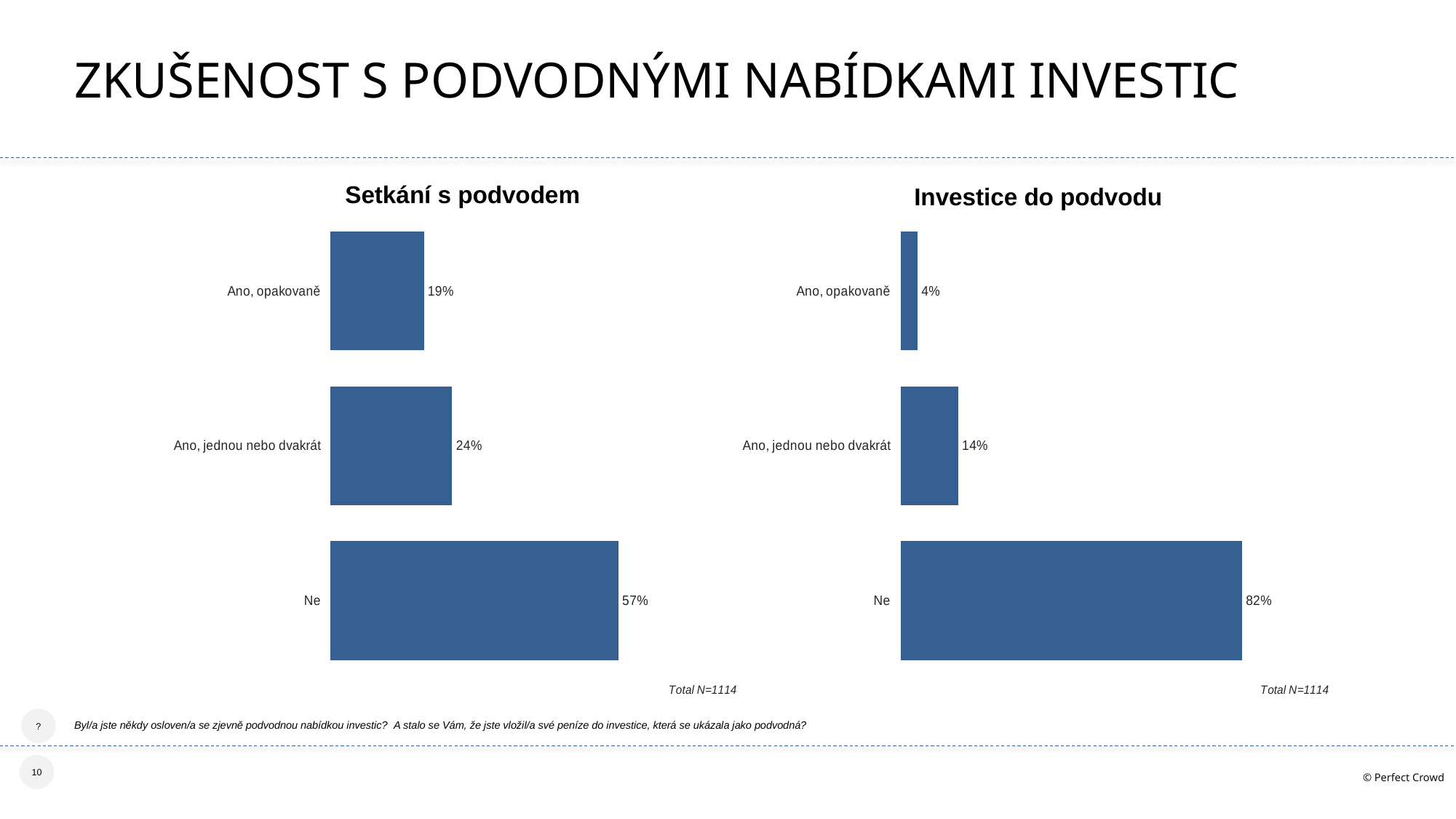
In the 'Investice do podvodu' chart, what is the value for 'Ano, opakovaně'? 4% In the 'Investice do podvodu' chart, what is the difference between 'Ne' and 'Ano, jednou nebo dvakrát'? 68% In the 'Investice do podvodu' chart, which category has the lowest value? Ano, opakovaně In the 'Setkání s podvodem' chart, what is the value for 'Ano, jednou nebo dvakrát'? 24% In the 'Investice do podvodu' chart, what is the value for 'Ano, jednou nebo dvakrát'? 14% Which is larger: 'Ne' in the 'Setkání s podvodem' chart or 'Ne' in the 'Investice do podvodu' chart? Ne in Investice do podvodu In the 'Setkání s podvodem' chart, what is the difference between 'Ano, jednou nebo dvakrát' and 'Ano, opakovaně'? 5% In the 'Setkání s podvodem' chart, which category has the highest value? Ne What is the title of the chart on the left side of the slide? Setkání s podvodem In the 'Setkání s podvodem' chart, what is the value for 'Ne'? 57% How many categories does the 'Setkání s podvodem' chart show? 3 What kind of chart is the 'Investice do podvodu' chart? Bar chart